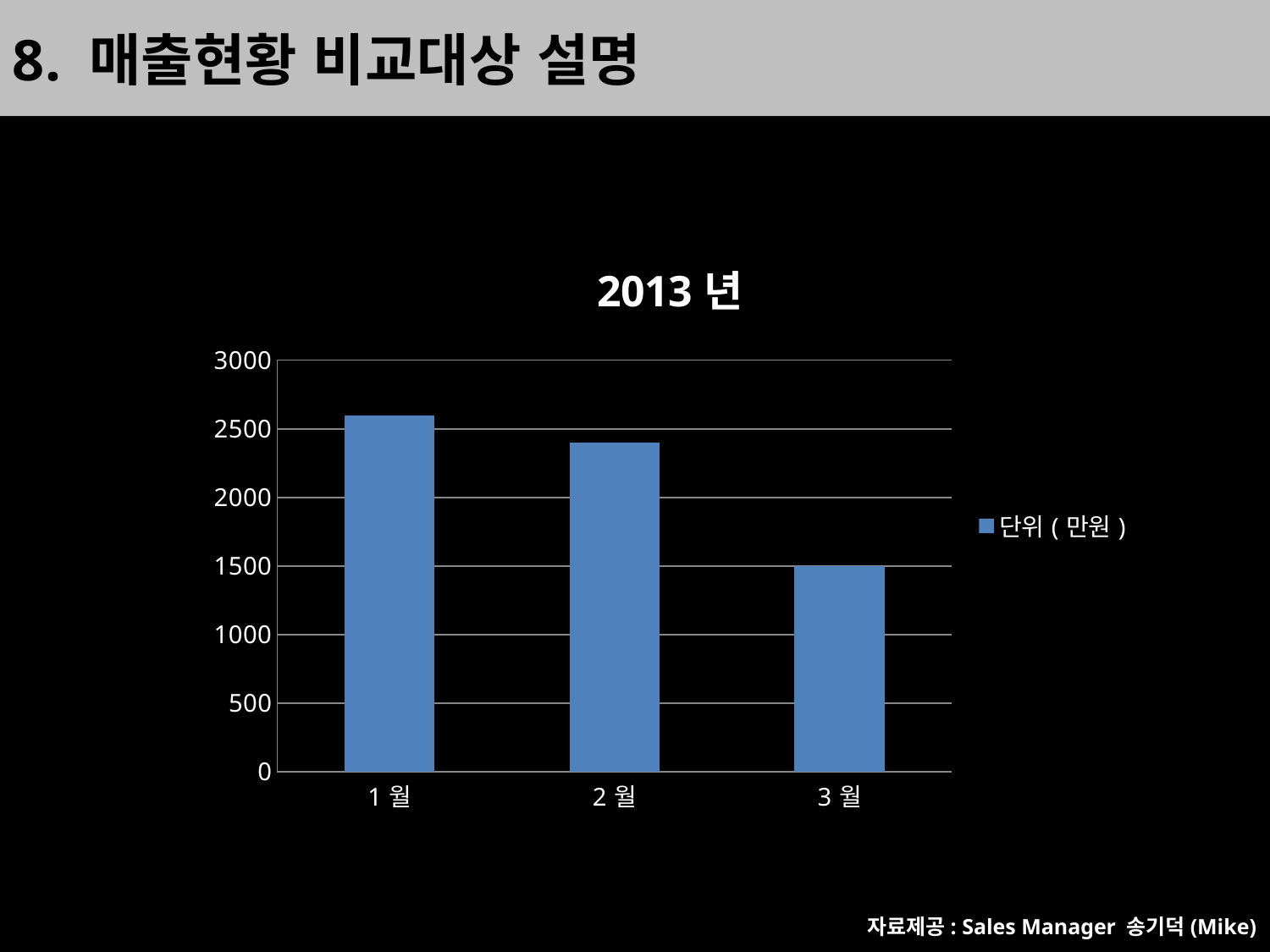
Which month has the lowest value in the chart? 3 월 What is the title of the chart? 2013 년 What is the value for 3 월? 1500 How many categories are shown on the x axis of the chart? 3 Which month has the highest value in the chart? 1 월 What kind of chart is shown on the slide? bar chart Do the values rise or fall from 1 월 to 3 월? fall Is the value for 1 월 greater or less than 2500? greater Which is larger, the value for 1 월 or the value for 2 월? 1 월 Is the value for 2 월 greater or less than 2500? less What is the legend entry shown for the series? 단위 ( 만원 ) How many series does the chart's legend list? 1